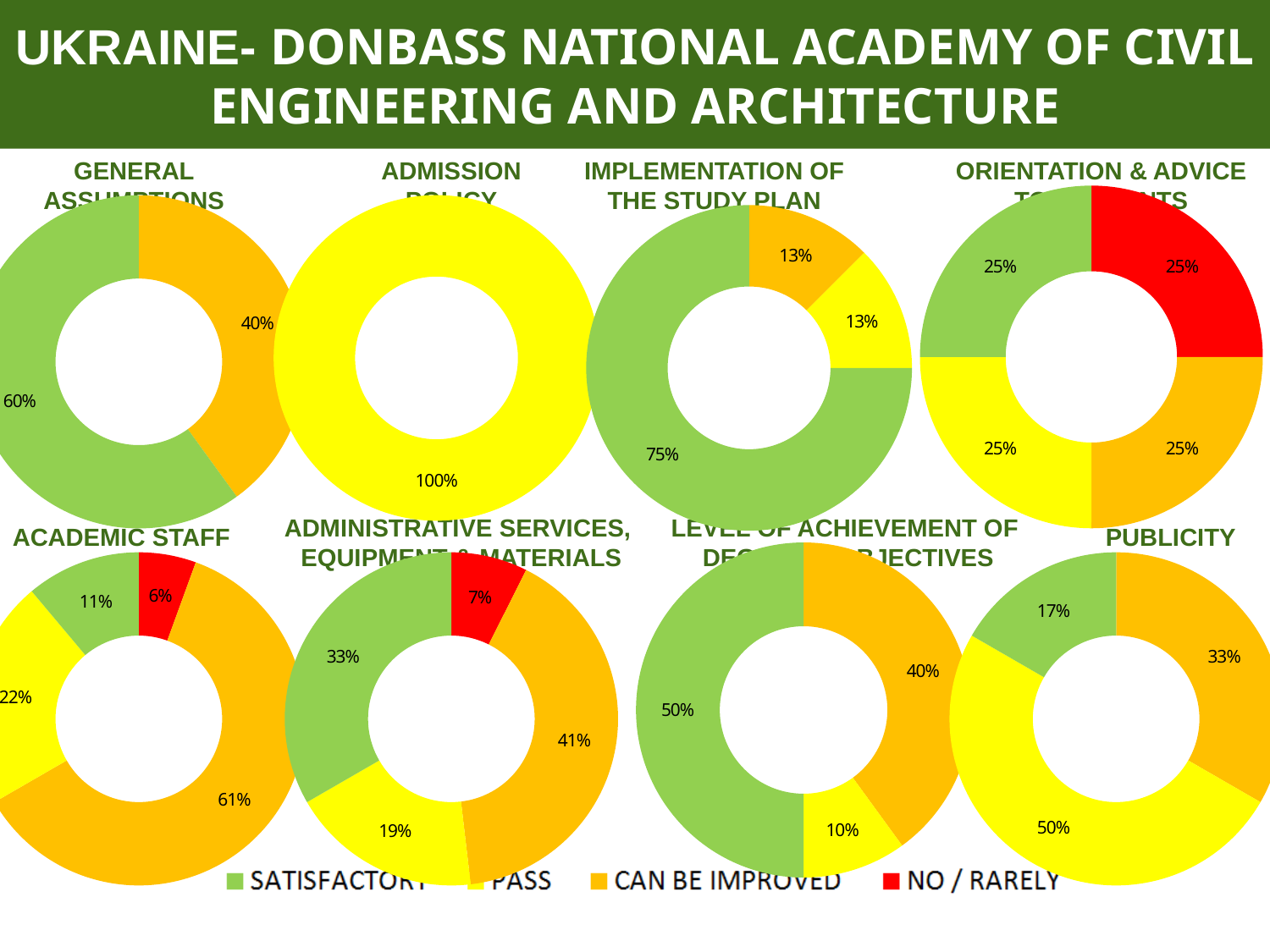
In the Administrative Services, Equipment & Materials chart, what is the difference between the Can be improved share and the Satisfactory share? 8% In the Admission Policy chart, what share is Pass? 100% In the Level of Achievement of Degree Objectives chart, what share is Pass? 10% In the Publicity chart, which is larger, the Pass share or the Can be improved share? Pass How many entries does the legend list? 4 How many categories are shown in the Orientation & Advice to Students chart? 4 Which colour represents No / Rarely in the legend? Red In the Implementation of the Study Plan chart, what share is Satisfactory? 75% In the Academic Staff chart, which category has the smallest share? No / Rarely In the Academic Staff chart, which category has the largest share? Can be improved What kind of chart is the Academic Staff chart? Doughnut chart In the General Assumptions chart, what share is Satisfactory? 60%